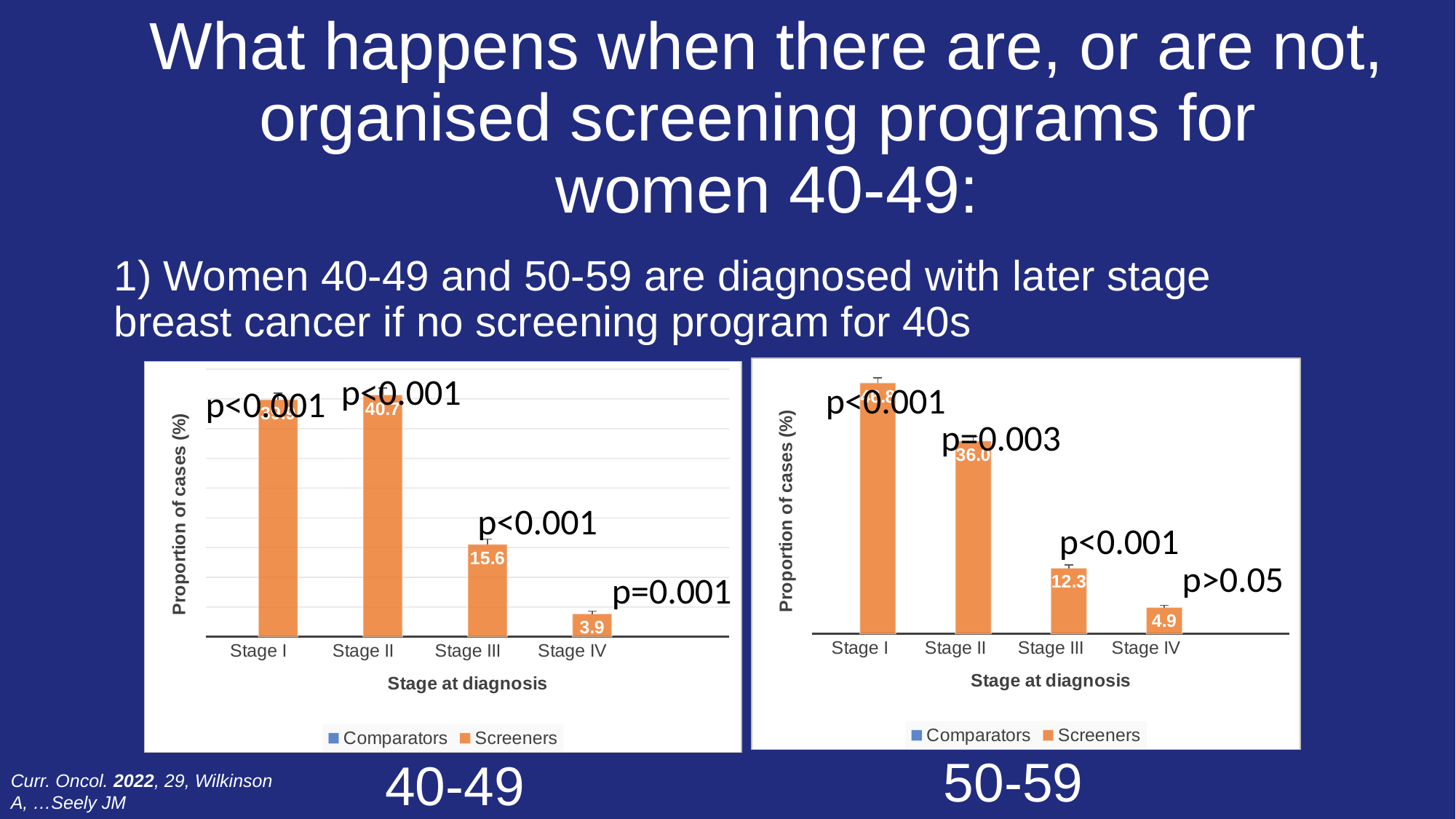
In the 40-49 chart, which stage has the lowest proportion of cases? Stage IV In the 50-59 chart, what is the proportion of cases for Stage IV? 4.9 In the 50-59 chart, what is the proportion of cases for Stage III? 12.3 How many series does the legend of the 40-49 chart list? 2 In the 40-49 chart, what is the proportion of cases for Stage IV? 3.9 In the 50-59 chart, what is the proportion of cases for Stage II? 36.0 In the 40-49 chart, what is the proportion of cases for Stage III? 15.6 In the 50-59 chart, which stage has the highest proportion of cases? Stage I In the 50-59 chart, which is larger, the value for Stage III or Stage IV? Stage III In the 50-59 chart, what is the difference between the Stage II and Stage III values? 23.7 In the 40-49 chart, what is the proportion of cases for Stage II? 40.7 In the 40-49 chart, what is the difference between the Stage III and Stage IV values? 11.7